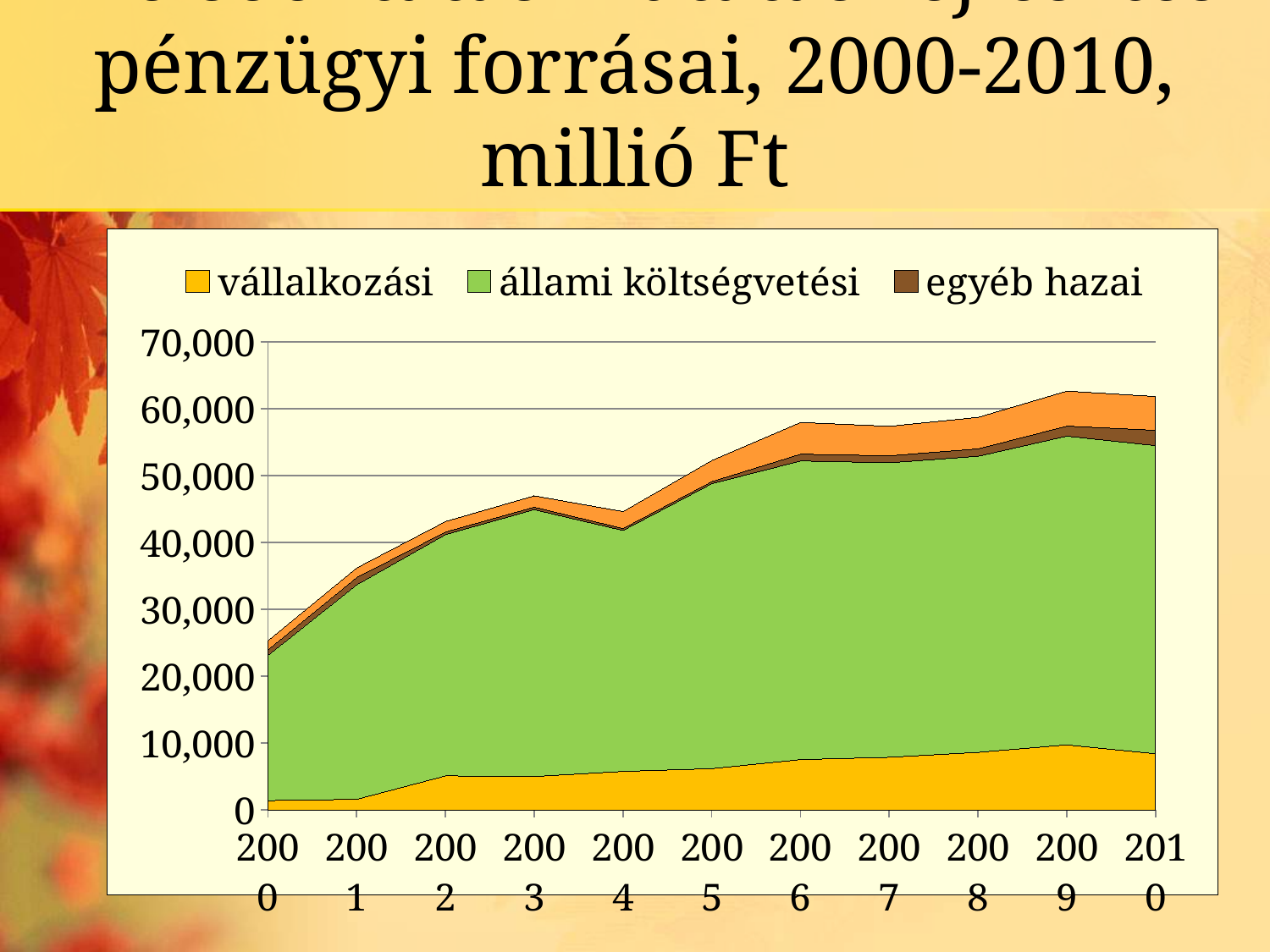
Is the vállalkozási value for 2000 greater or less than 10,000? less Which is larger, the total value for 2010 or for 2000? 2010 Which series is shown in green in the legend? állami költségvetési How many series does the legend list? 3 Which years does the x axis cover? 2000 to 2010 Do the total values generally rise or fall from 2000 to 2010? Rise Is the total value for 2004 greater or less than 50,000? less What kind of chart is shown on the slide? Stacked area chart Is the total value for 2010 greater or less than 60,000? greater How many years are plotted along the x axis? 11 Which year has the lowest total value? 2000